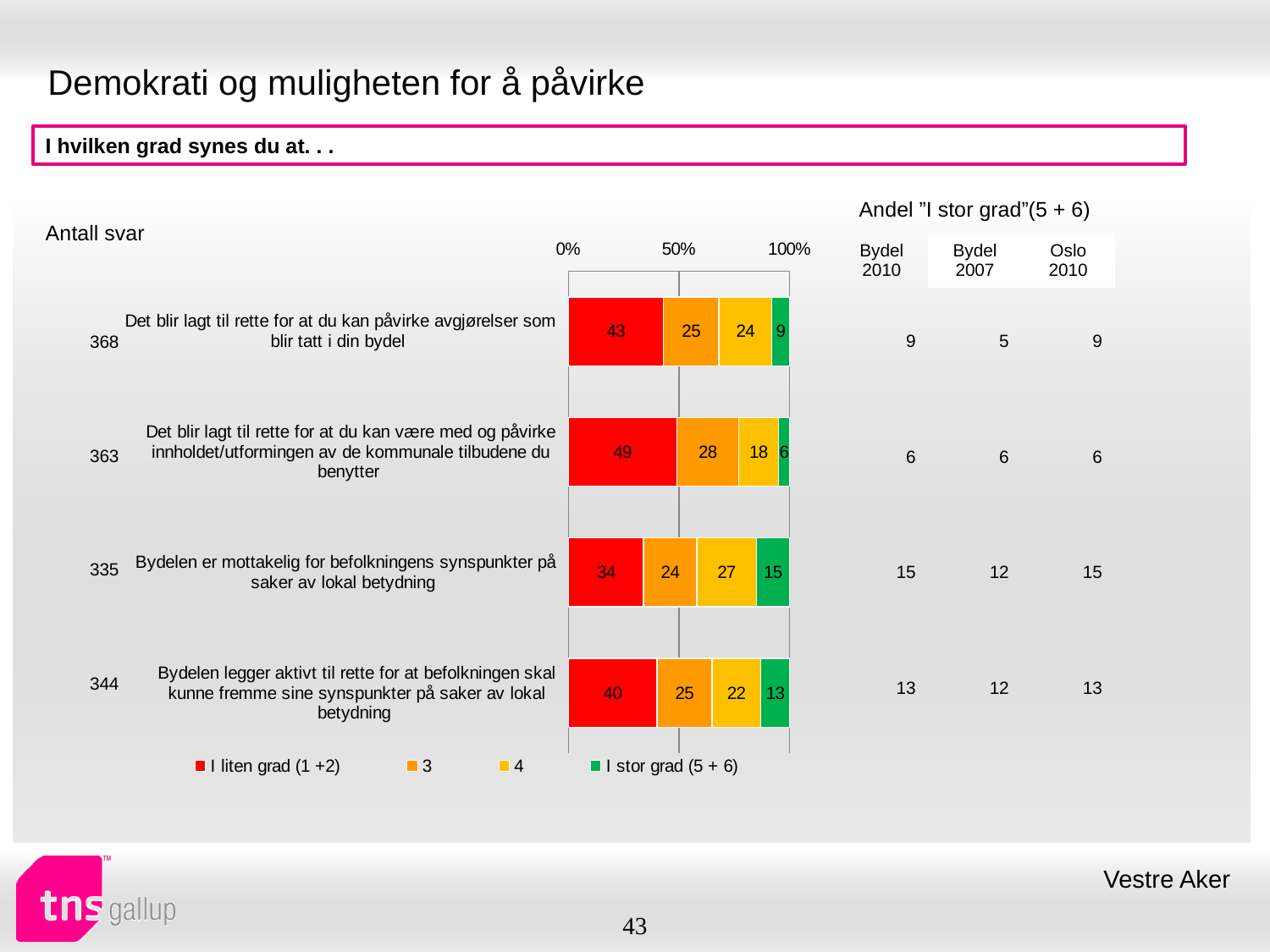
Which statement has the lowest 'I stor grad (5 + 6)' value? Det blir lagt til rette for at du kan være med og påvirke innholdet/utformingen av de kommunale tilbudene du benytter What kind of chart is shown on the slide? stacked bar chart How many statements (categories) are plotted in the bar chart? 4 What colour represents the 'I stor grad (5 + 6)' series in the chart? green Which statement has the highest 'I liten grad (1 +2)' value? Det blir lagt til rette for at du kan være med og påvirke innholdet/utformingen av de kommunale tilbudene du benytter What is the difference between the 'I liten grad (1 +2)' values for 'Det blir lagt til rette for at du kan være med og påvirke innholdet/utformingen av de kommunale tilbudene du benytter' and 'Bydelen er mottakelig for befolkningens synspunkter på saker av lokal betydning'? 15 What is the total of the stacked bar for 'Bydelen legger aktivt til rette for at befolkningen skal kunne fremme sine synspunkter på saker av lokal betydning'? 100 What is the 'I liten grad (1 +2)' value for 'Bydelen er mottakelig for befolkningens synspunkter på saker av lokal betydning'? 34 What is the 'I stor grad (5 + 6)' value for 'Det blir lagt til rette for at du kan påvirke avgjørelser som blir tatt i din bydel'? 9 Which is larger: the series '3' value for 'Det blir lagt til rette for at du kan være med og påvirke innholdet/utformingen av de kommunale tilbudene du benytter' or for 'Bydelen er mottakelig for befolkningens synspunkter på saker av lokal betydning'? Det blir lagt til rette for at du kan være med og påvirke innholdet/utformingen av de kommunale tilbudene du benytter How many series does the chart legend list? 4 What is the value of series '4' for 'Bydelen legger aktivt til rette for at befolkningen skal kunne fremme sine synspunkter på saker av lokal betydning'? 22